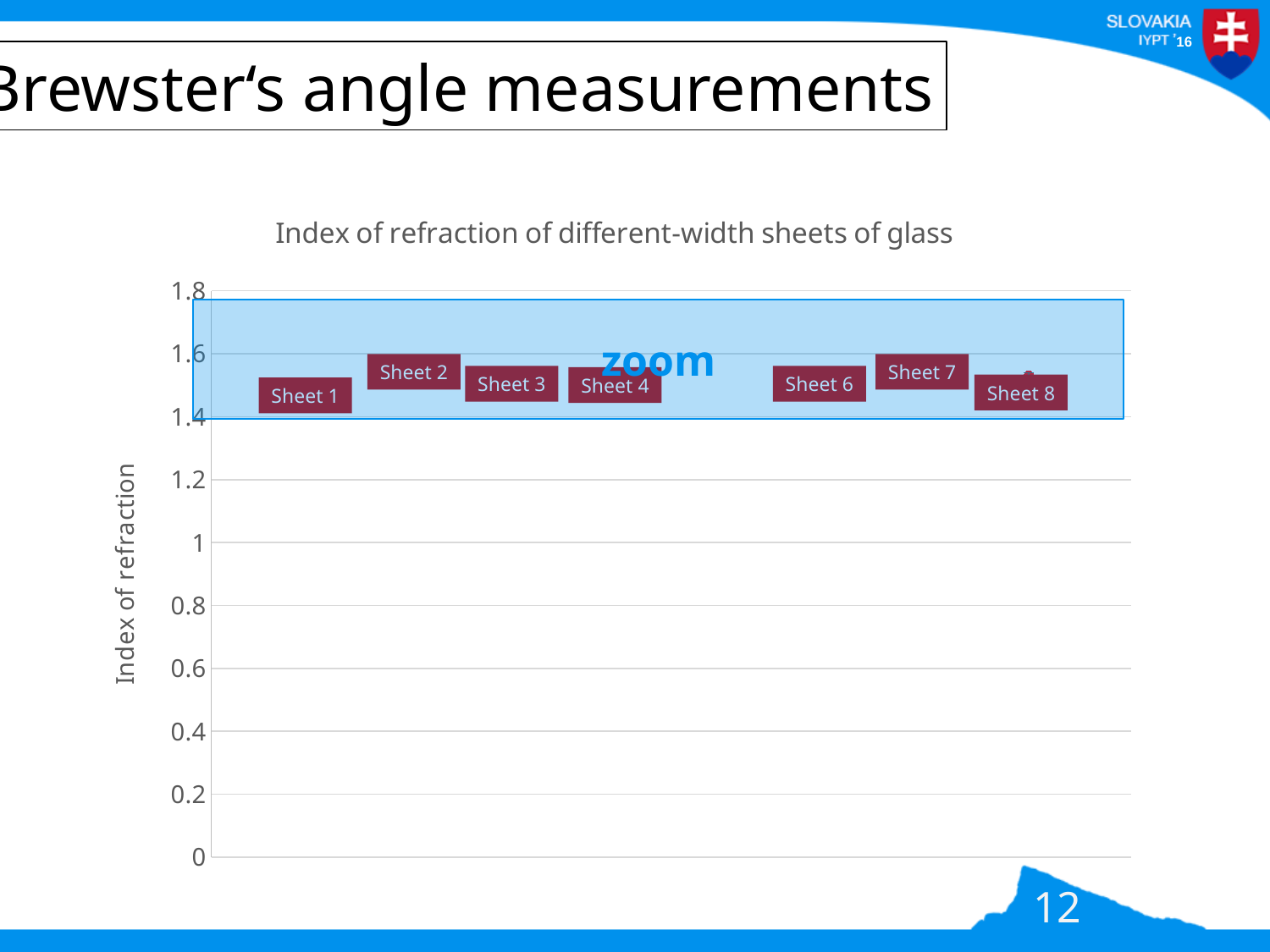
Is the value for Sheet 1 greater or less than 1? greater What is the label on the vertical axis of the chart? Index of refraction Is the value for Sheet 6 greater or less than 0.8? greater What is the title of the chart? Index of refraction of different-width sheets of glass Is the value for Sheet 3 greater or less than 1.8? less